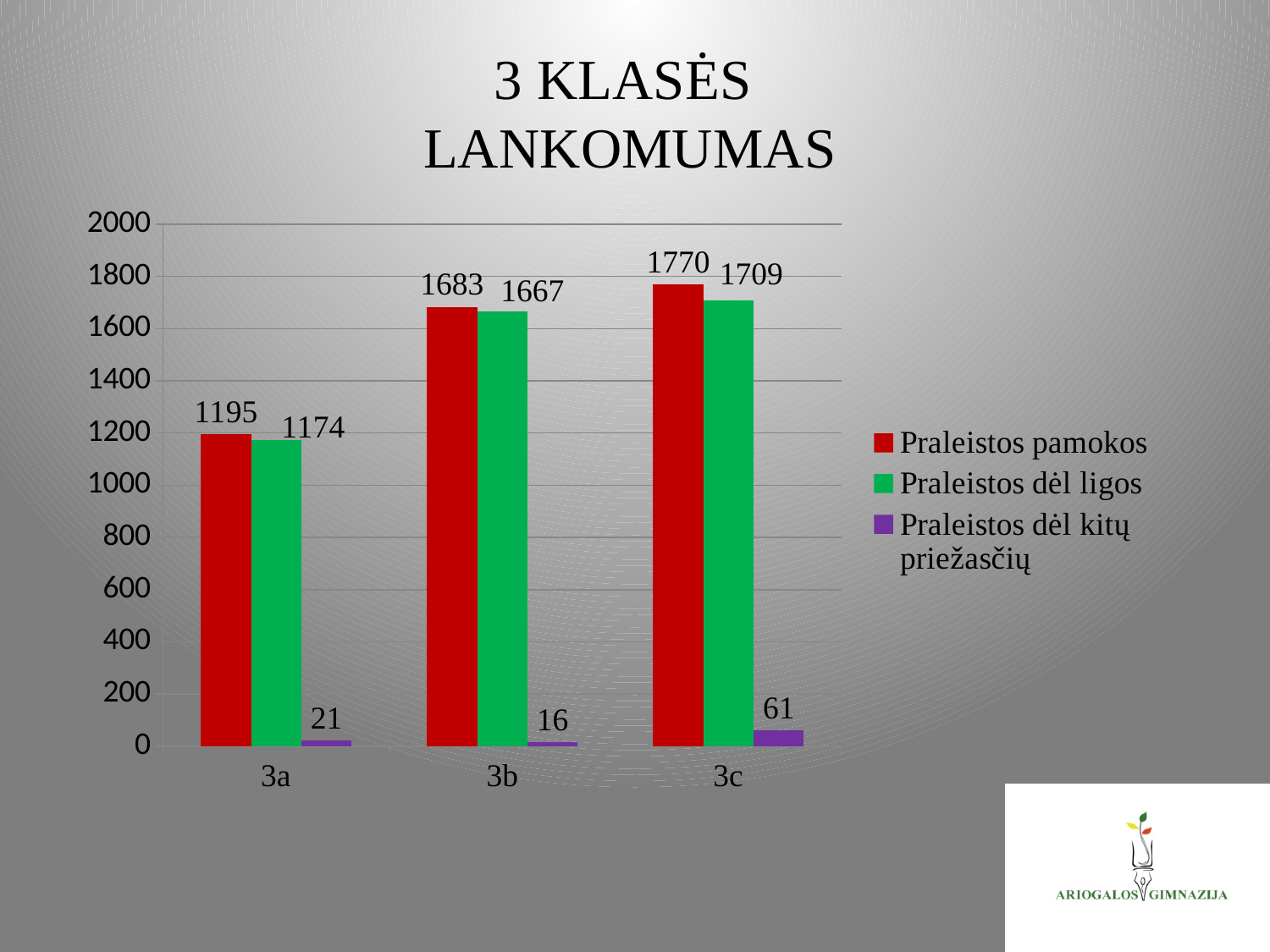
What is the difference between Praleistos pamokos and Praleistos dėl ligos for 3c? 61 Which class has the highest value for Praleistos pamokos? 3c What is the title of the slide? 3 KLASĖS LANKOMUMAS Which class has the lowest value for Praleistos dėl kitų priežasčių? 3b What is the value of Praleistos dėl ligos for 3b? 1667 What is the value of Praleistos dėl kitų priežasčių for 3c? 61 How many series does the legend list? 3 Is the value of Praleistos pamokos for 3b greater or less than 1600? greater What is the value of Praleistos pamokos for 3a? 1195 Which is larger: Praleistos dėl ligos for 3b or Praleistos dėl ligos for 3a? 3b What kind of chart is shown on the slide? bar chart How many classes are shown on the x axis? 3